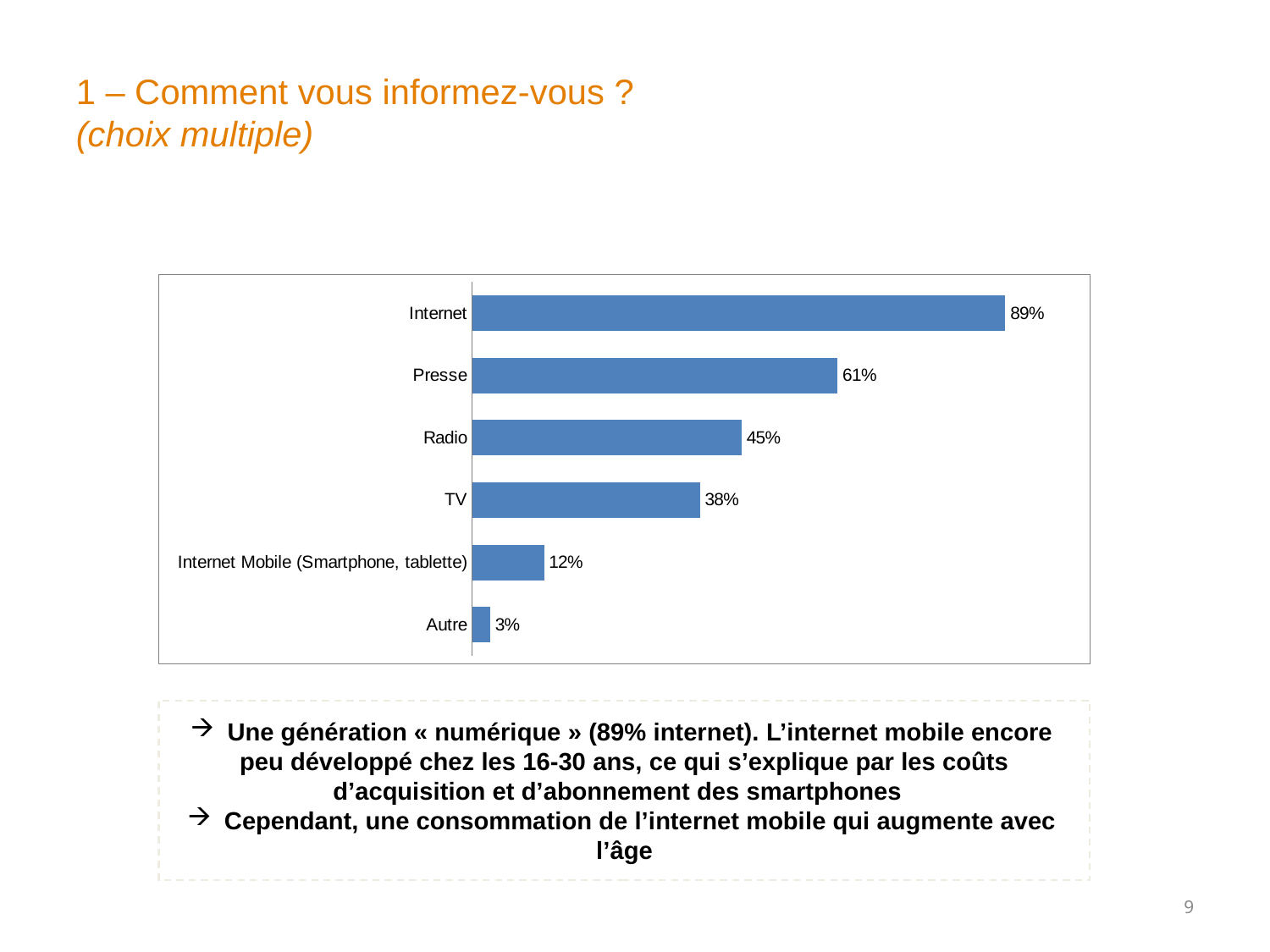
Which category has the highest value? Internet What kind of chart is shown on the slide? Bar chart What percentage of respondents use Internet to get information? 89% What is the difference between the values for Internet and Presse? 28% What is the value shown for Presse? 61% What is the value shown for Radio? 45% What is the value shown for Autre? 3% Which category has the lowest value? Autre What is the difference between the values for Radio and TV? 7% What is the value shown for Internet Mobile (Smartphone, tablette)? 12% Which is larger, the value for TV or the value for Radio? Radio How many categories are shown in the chart? 6